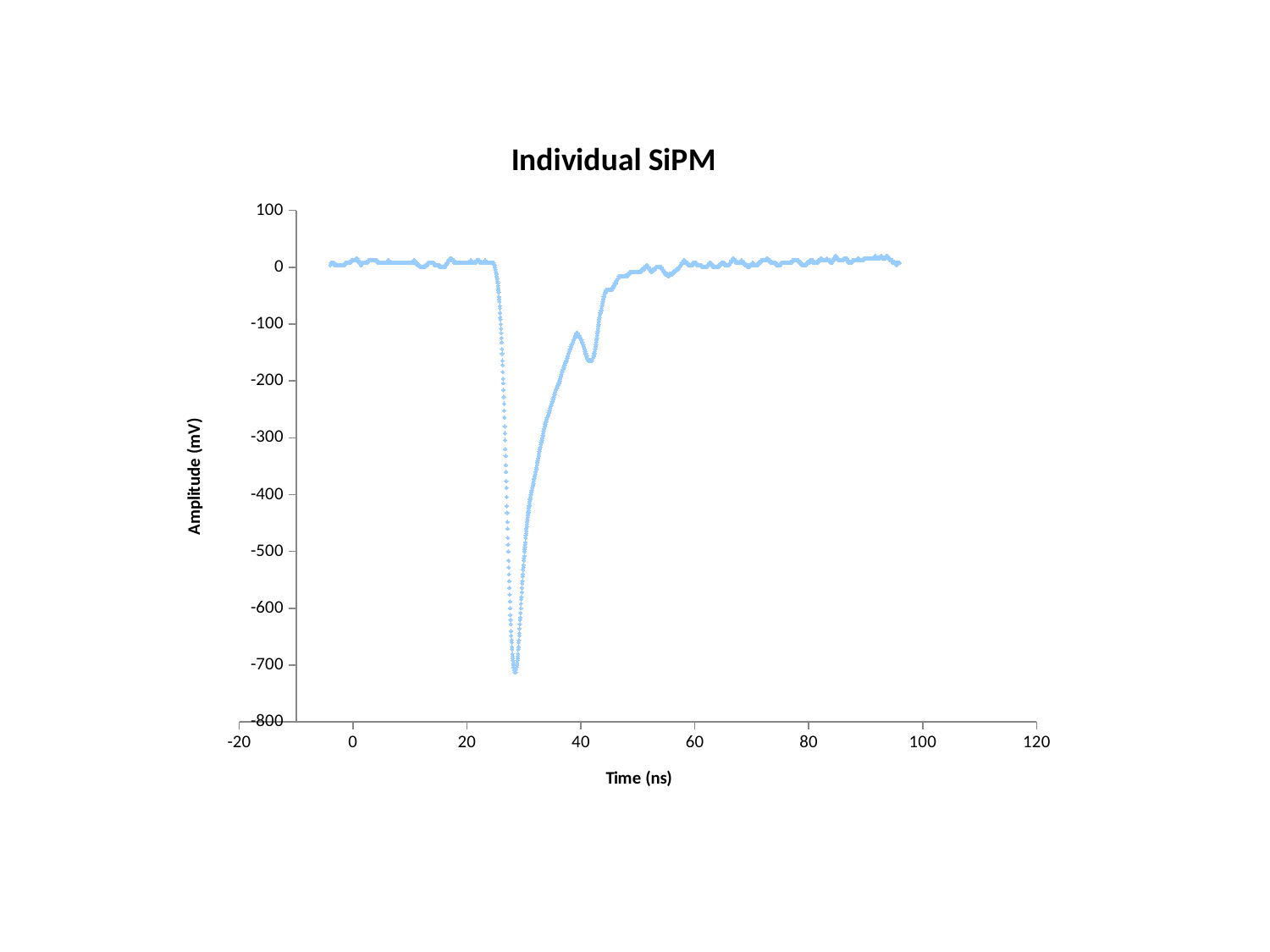
What kind of chart is shown on the slide? scatter chart What is the label of the y axis? Amplitude (mV) Is the amplitude at time 30 ns greater or less than -300? less What is the title of the chart? Individual SiPM Is the amplitude at time 80 ns greater or less than -100? greater Is the amplitude at time 40 ns greater or less than -300? greater Do the amplitude values rise or fall between 30 ns and 40 ns? rise Between which two x-axis ticks does the lowest amplitude occur? 20 and 40 What is the lowest value shown on the y axis? -800 Do the amplitude values rise or fall between 25 ns and 28 ns? fall